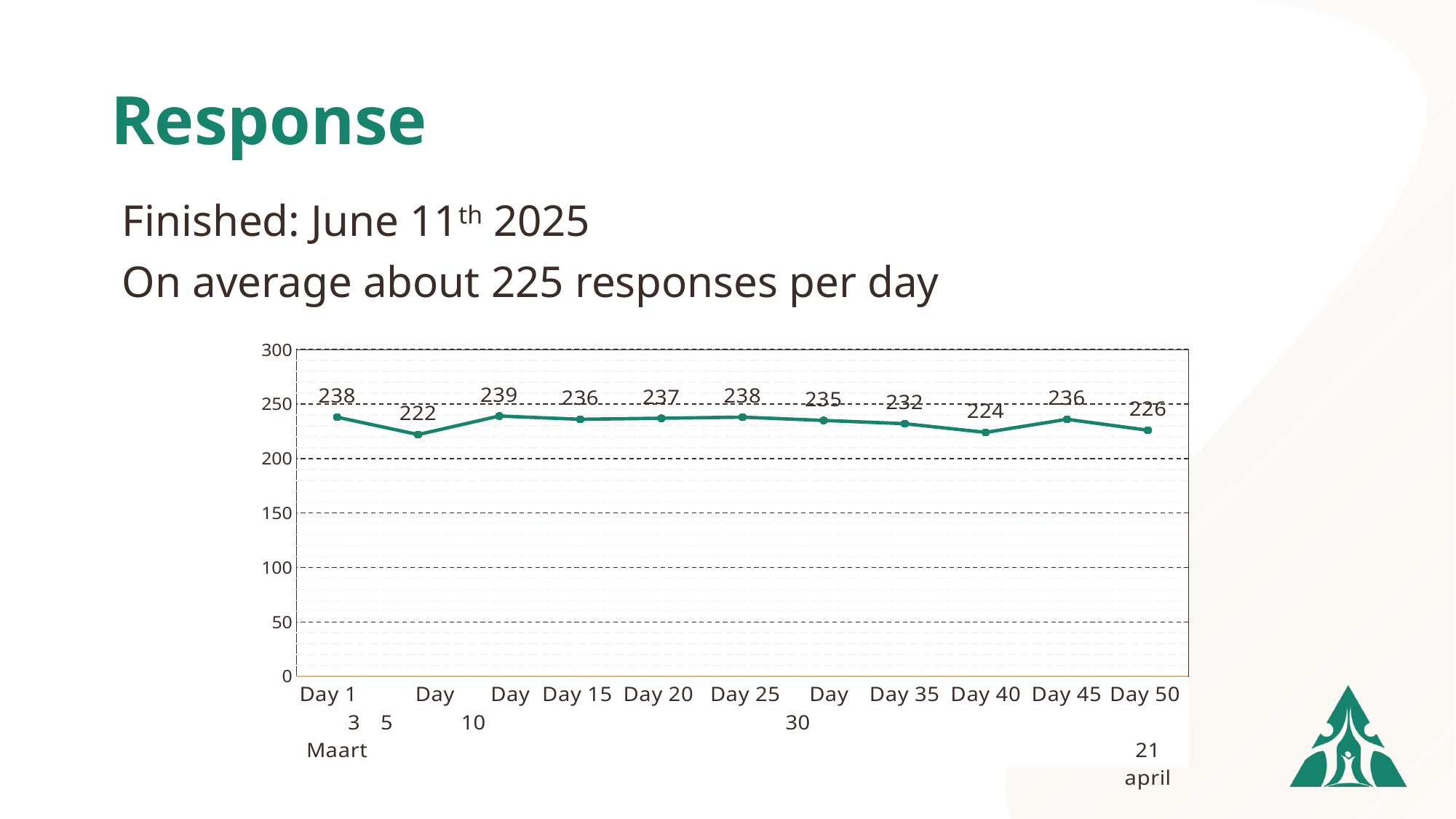
What is the value for Day 40? 224 What kind of chart is shown on the slide? line chart How many data points are plotted on the chart? 11 What is the highest value shown on the y axis? 300 What is the difference between the values for Day 45 and Day 40? 12 Which day has the lowest value? Day 5 What is the difference between the values for Day 10 and Day 5? 17 Is the value for Day 20 greater or less than 200? greater What is the value for Day 50? 226 Which day has the highest value? Day 10 Which is larger, the value for Day 35 or the value for Day 50? Day 35 What is the value for Day 1? 238